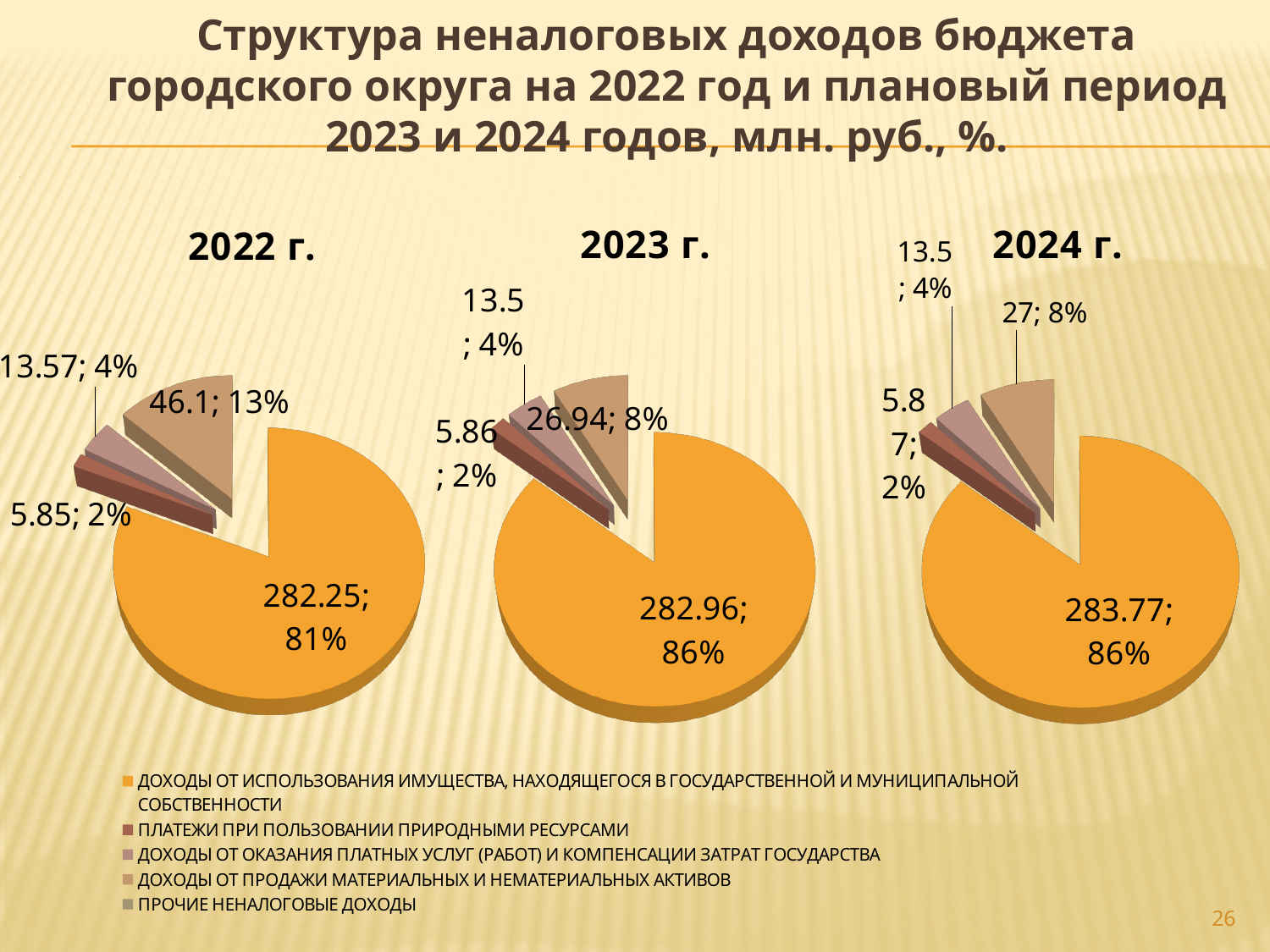
In the 2022 г. chart, what is the difference between the value for доходы от продажи материальных и нематериальных активов (46.1) and the value for доходы от оказания платных услуг (13.57)? 32.53 How many categories does the legend list? 5 Is the value for доходы от продажи материальных и нематериальных активов larger in the 2022 г. chart or in the 2023 г. chart? 2022 г. In the 2022 г. chart, which category has the largest slice? Доходы от использования имущества, находящегося в государственной и муниципальной собственности In the 2023 г. chart, what value is shown for доходы от продажи материальных и нематериальных активов? 26.94 In the 2024 г. chart, what share is shown for доходы от продажи материальных и нематериальных активов? 8% What kind of chart is used for each of the three years on the slide? Pie chart In the 2024 г. chart, what value is shown for доходы от использования имущества, находящегося в государственной и муниципальной собственности? 283.77 In the 2023 г. chart, what share is shown for доходы от использования имущества, находящегося в государственной и муниципальной собственности? 86% In the 2023 г. chart, which category has the smallest slice? Платежи при пользовании природными ресурсами In the 2022 г. chart, what value is shown for доходы от использования имущества, находящегося в государственной и муниципальной собственности? 282.25 In the 2022 г. chart, what share is shown for доходы от продажи материальных и нематериальных активов? 13%